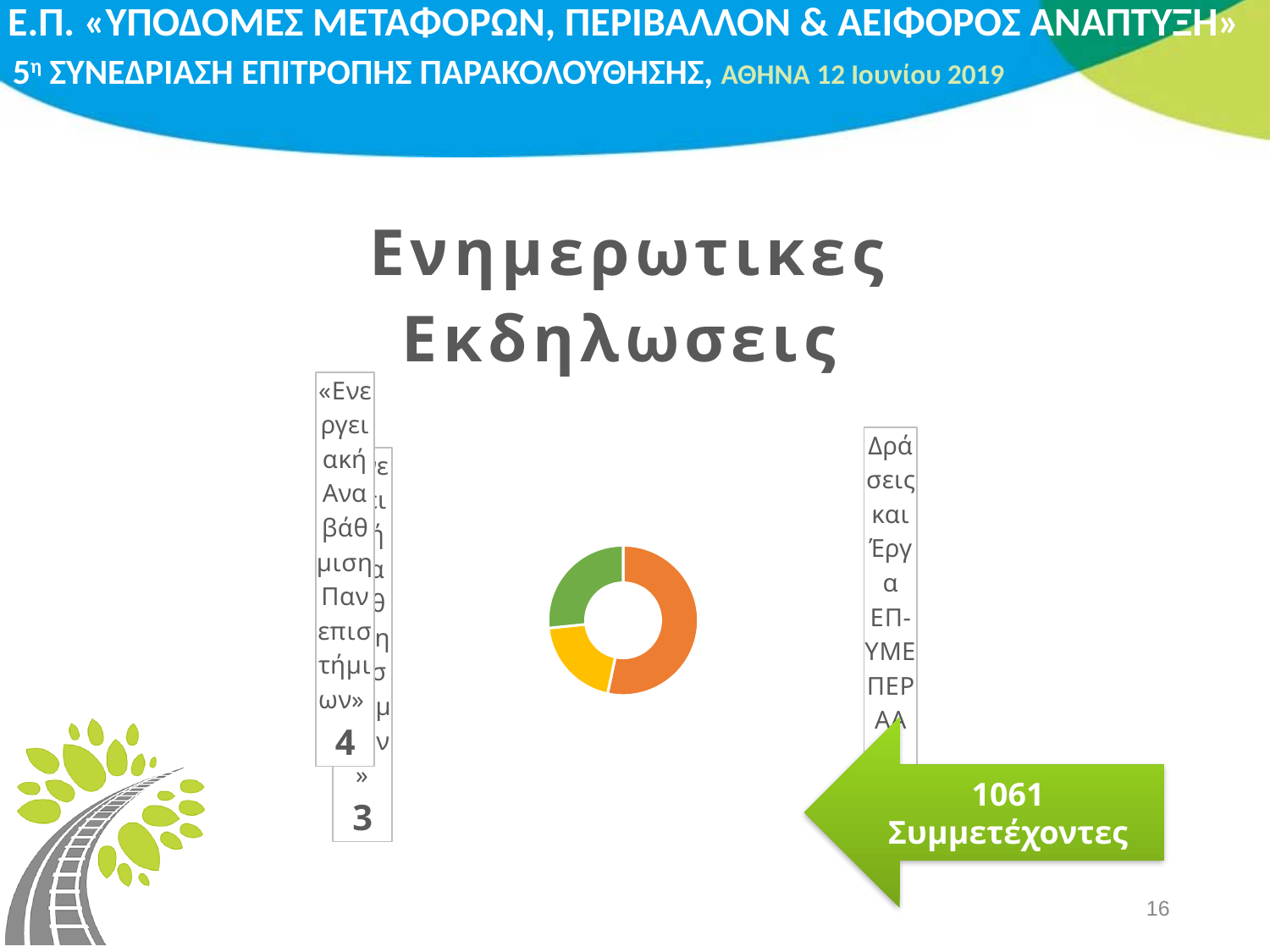
How many slices does the doughnut chart have? 3 What kind of chart is shown on the slide? doughnut chart What value is shown for «Ενεργειακή Αναβάθμιση Πανεπιστημίων»? 4 Is the orange slice larger or smaller than the green slice? larger Which colour slice is the largest in the doughnut chart? orange What is the title of the chart? Ενημερωτικες Εκδηλωσεις